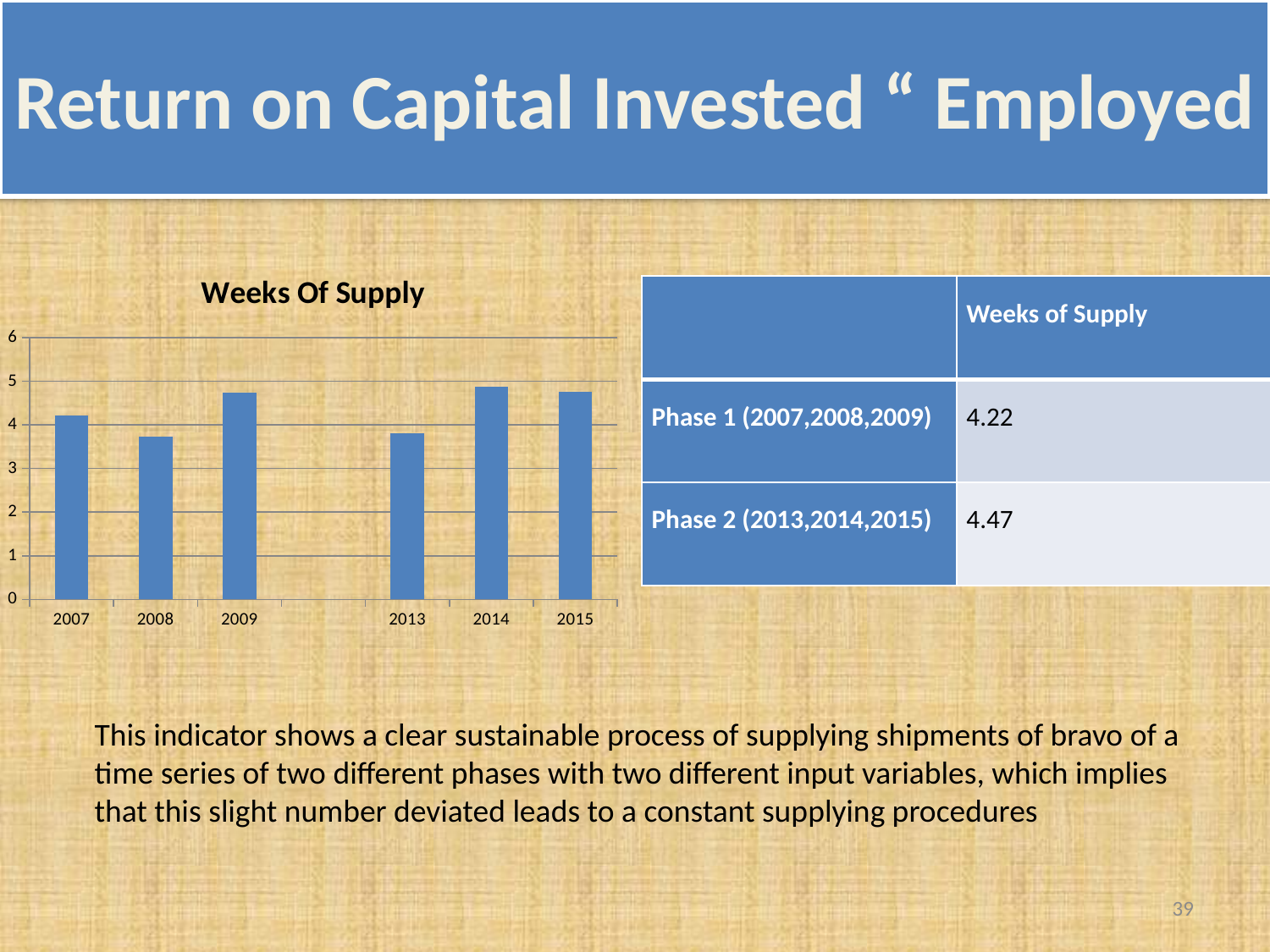
Is the value for 2008 greater or less than 4? less Is the value for 2008 greater or less than 3? greater Is the value for 2007 greater or less than 4? greater Which is larger, the value for 2009 or the value for 2013? 2009 Which is larger, the value for 2007 or the value for 2008? 2007 What is the title of the chart? Weeks Of Supply How many years are shown on the x axis of the chart? 6 What is the highest value shown on the y axis of the chart? 6 What kind of chart is shown on the slide? bar chart